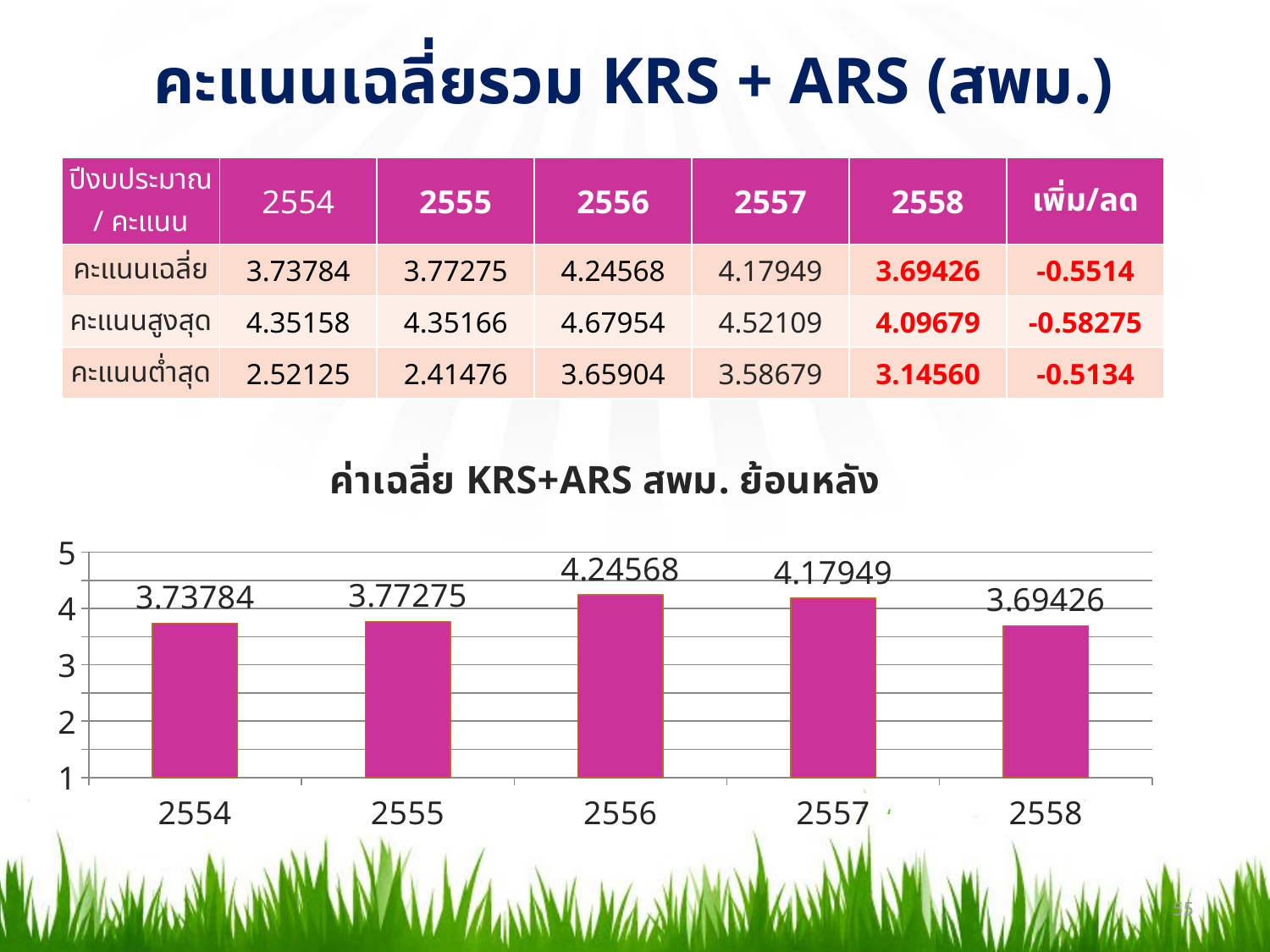
What kind of chart is shown on the slide? bar chart Which year has the highest value in the chart? 2556 Which year has the lowest value in the chart? 2558 What is the value for 2554 in the chart? 3.73784 How many years are shown on the x axis of the chart? 5 What is the value for 2556 in the chart? 4.24568 What is the title of the chart? ค่าเฉลี่ย KRS+ARS สพม. ย้อนหลัง What is the value for 2558 in the chart? 3.69426 Is the value for 2556 in the chart greater or less than 4? greater What is the difference between the values for 2556 and 2558 in the chart? 0.55142 What is the difference between the values for 2556 and 2557 in the chart? 0.06619 Which is larger in the chart, the value for 2554 or the value for 2555? 2555